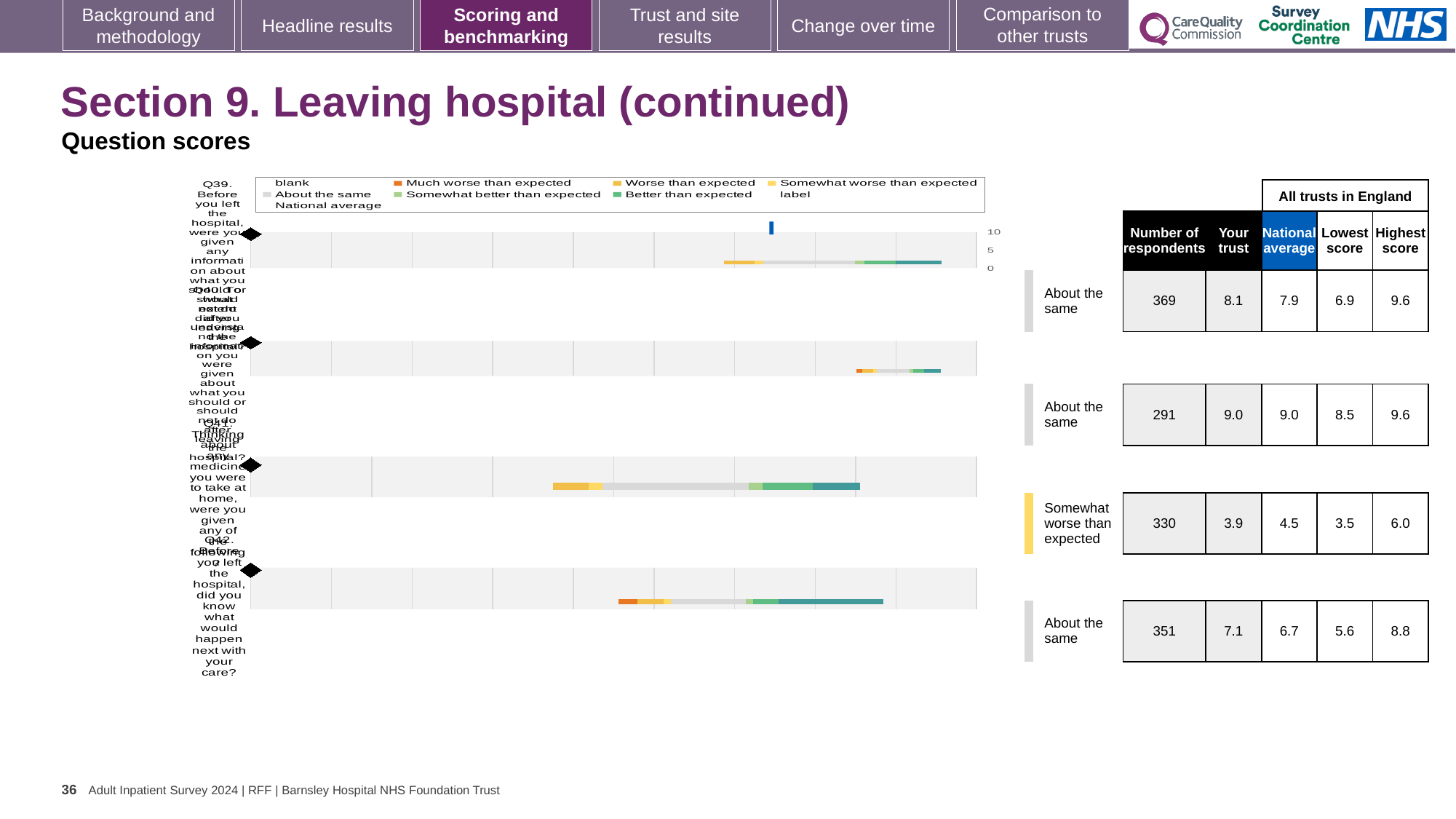
What kind of chart is shown on the slide? bar chart What colour does the legend use for 'Much worse than expected'? orange How many questions (rows) are plotted in the chart? 4 Which question has the highest 'Your trust' score? Q40 What is the 'Your trust' score for Q39 (the first row of the chart)? 8.1 What is the difference between the 'Your trust' score and the national average for Q39? 0.2 Which question has the lowest 'Your trust' score? Q41 What is the highest score among all trusts in England for Q40? 9.6 Is the 'Your trust' score for Q41 greater or less than 5? less What is the number of respondents for Q42 (the last row of the chart)? 351 For Q42, which is larger: the 'Your trust' score or the national average? Your trust What benchmark category is shown for Q41 (the third row of the chart)? Somewhat worse than expected